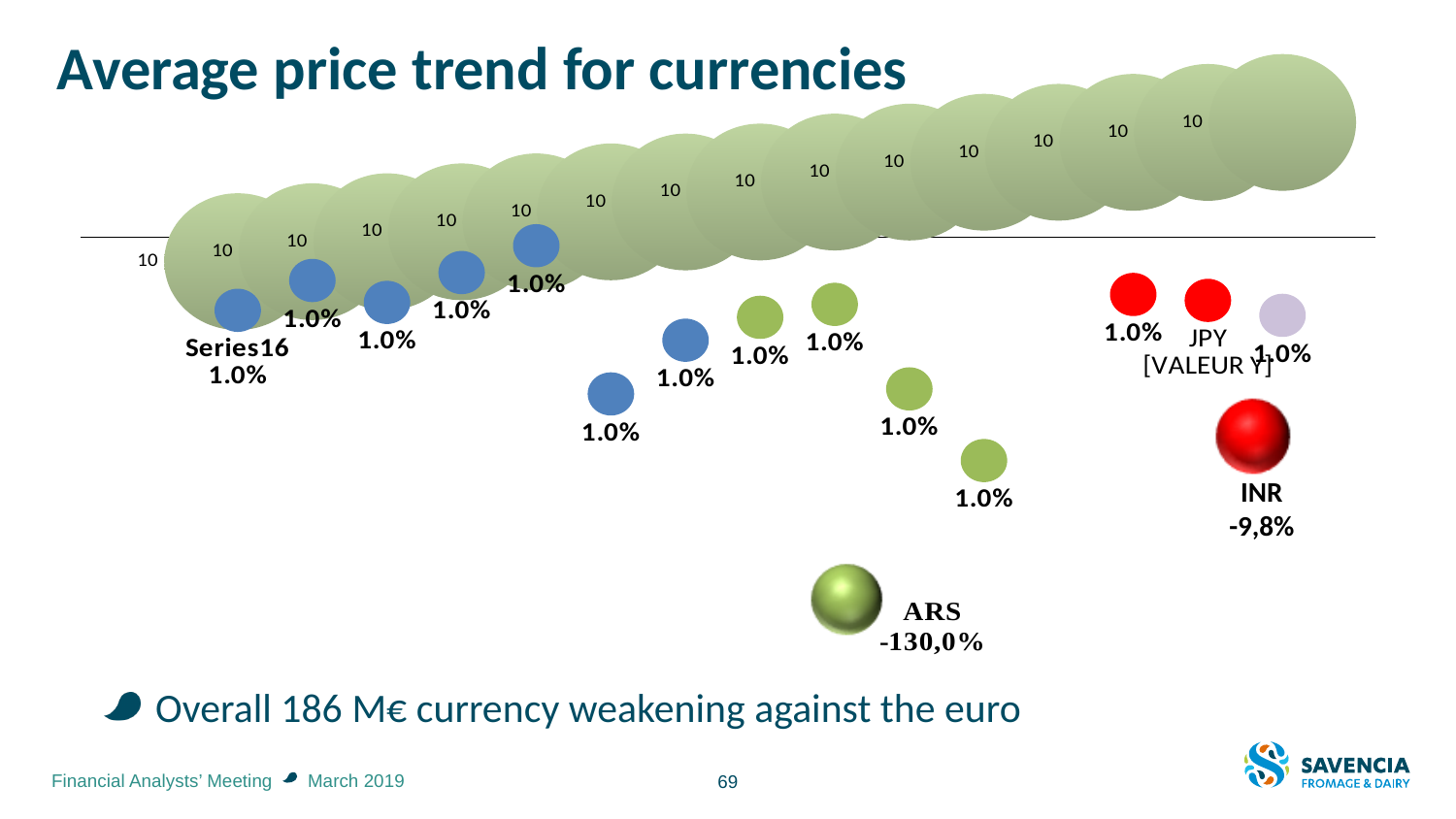
Which currency has the lowest value shown on the chart? ARS What value is shown for INR? -9,8% Which is larger, the value for INR or the value for ARS? INR What value is shown for ARS? -130,0% What colour is the bubble for INR? red What is the difference between the value for INR and the value for ARS? 120,2% What is the title of the chart on the slide? Average price trend for currencies What kind of chart is shown on the slide? bubble chart